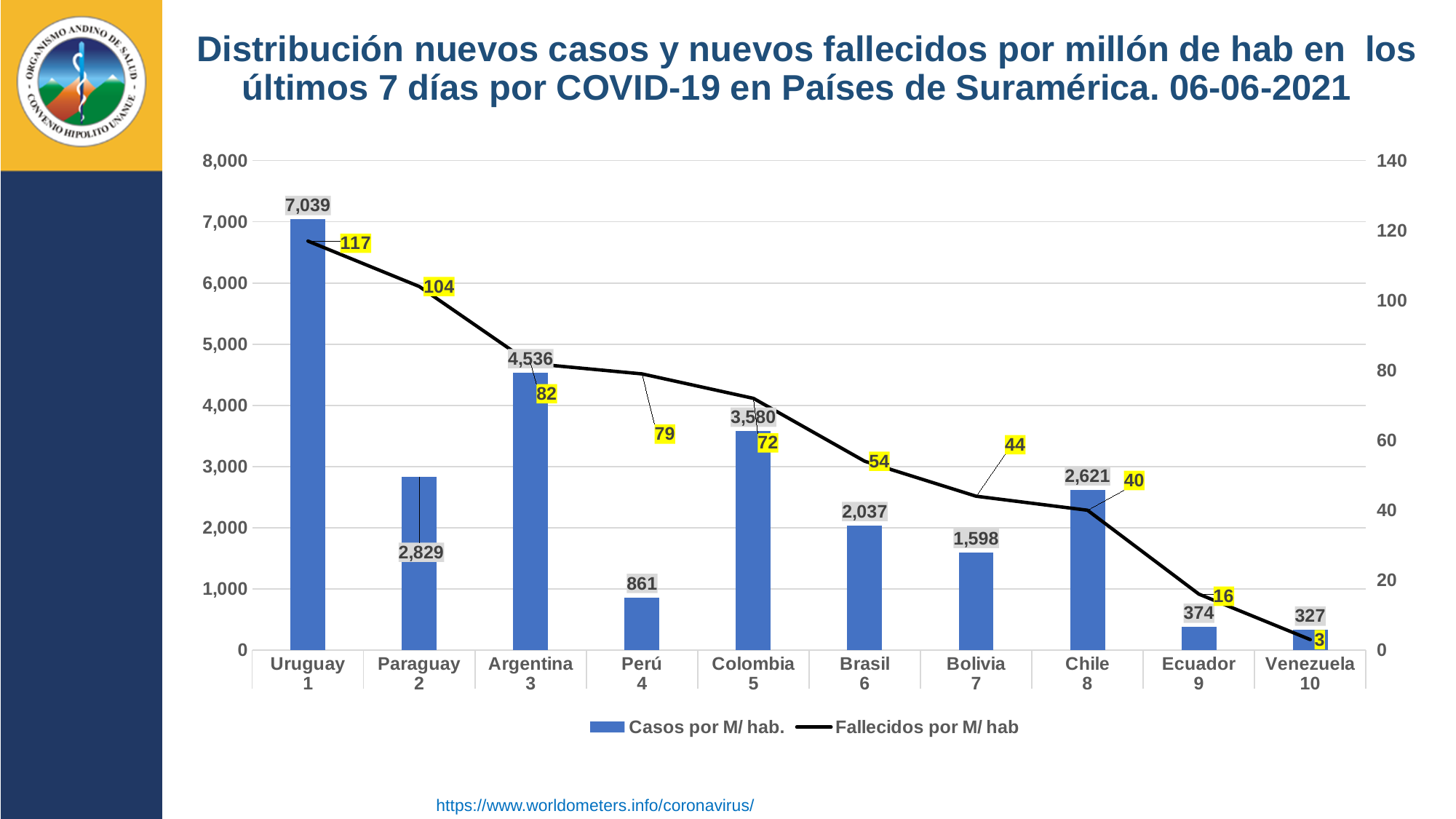
What is the value of Fallecidos por M/ hab for Paraguay? 104 How many series does the legend list? 2 What is the value of Casos por M/ hab. for Uruguay? 7,039 What is the difference in Casos por M/ hab. between Argentina and Colombia? 956 Does the Fallecidos por M/ hab line rise or fall from Uruguay to Venezuela? fall Which country has the lowest value of Casos por M/ hab.? Venezuela What colour are the Casos por M/ hab. bars? blue What is the value of Casos por M/ hab. for Bolivia? 1,598 What is the value of Fallecidos por M/ hab for Venezuela? 3 Which has a higher value of Casos por M/ hab., Paraguay or Chile? Paraguay How many countries are shown on the x axis? 10 Which country has the highest value of Casos por M/ hab.? Uruguay